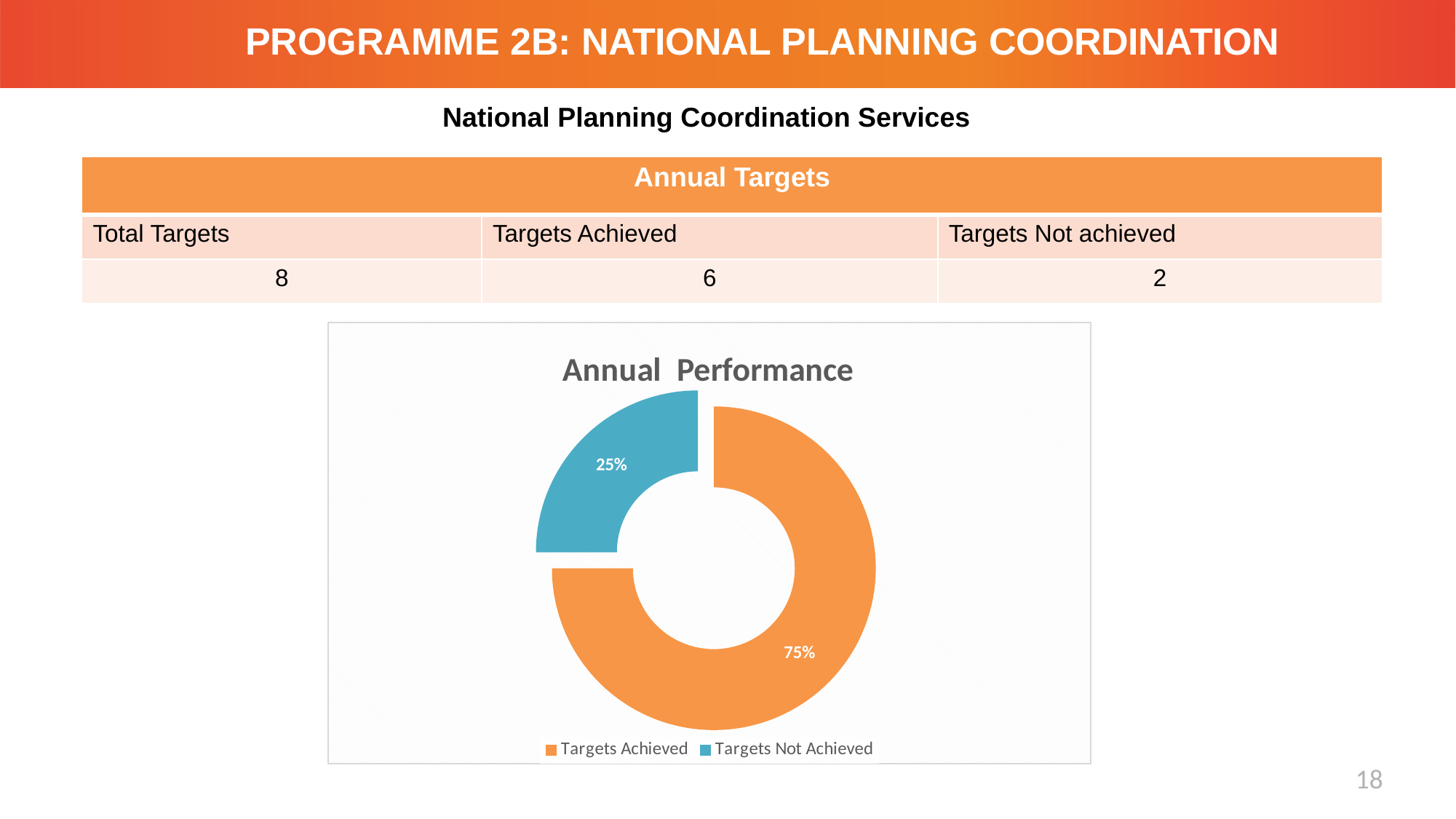
Which is larger, the share for Targets Achieved or the share for Targets Not Achieved? Targets Achieved What is the title of the chart? Annual Performance What is the total of the two percentages shown on the chart? 100% What percentage of the chart is Targets Not Achieved? 25% How many entries does the chart legend list? 2 What percentage of the chart is Targets Achieved? 75% How many categories does the chart show? 2 Which category has the largest share of the chart? Targets Achieved What kind of chart is shown on the slide? doughnut chart What is the difference in percentage points between Targets Achieved and Targets Not Achieved? 50 Which category has the smallest share of the chart? Targets Not Achieved What colour is the Targets Not Achieved slice? blue